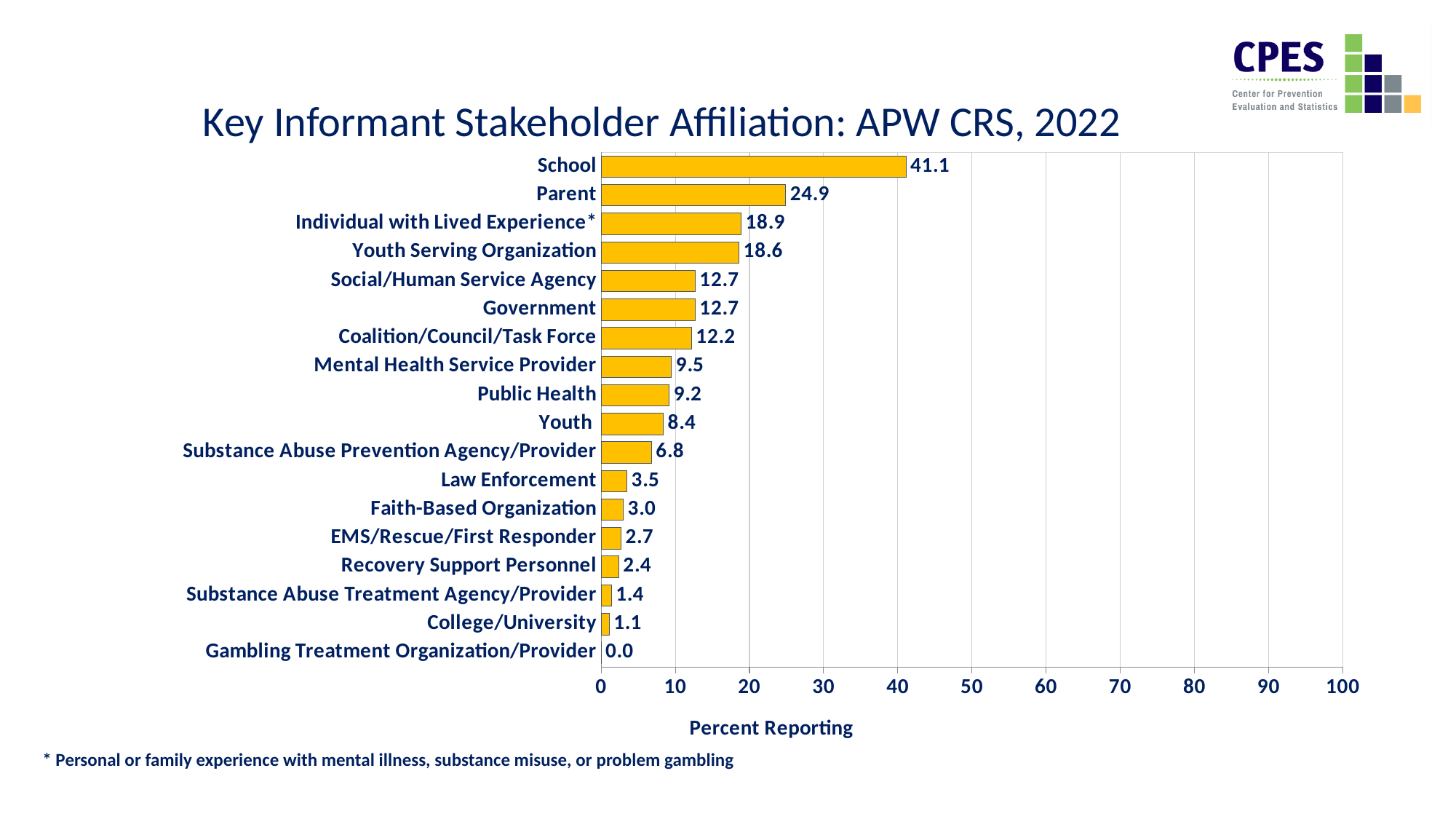
What is the difference between the values for School and Parent? 16.2 Which category has the highest value? School What is the title of the chart? Key Informant Stakeholder Affiliation: APW CRS, 2022 What is the value for Youth Serving Organization? 18.6 Is the value for Parent greater or less than 20? greater What is the label of the horizontal axis? Percent Reporting Which category has the lowest value? Gambling Treatment Organization/Provider How many categories are shown on the chart? 18 What is the value for School? 41.1 What kind of chart is shown on the slide? bar chart Which is larger, the value for Public Health or the value for Youth? Public Health What is the value for Law Enforcement? 3.5